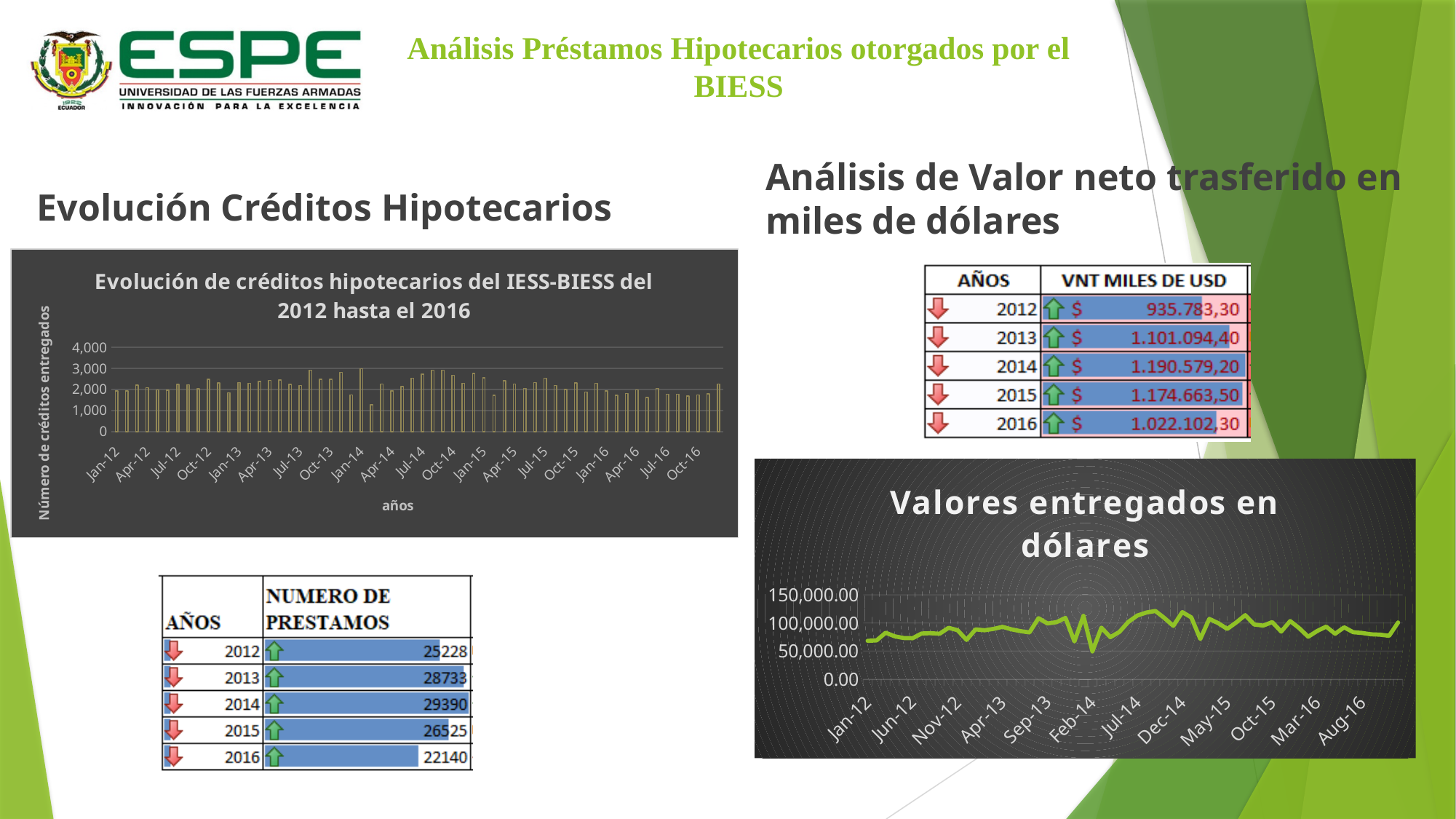
In the 'Valores entregados en dólares' line chart, is the value for Jan-12 greater or less than 100,000.00? less In the 'Evolución de créditos hipotecarios' bar chart, is the value for Oct-13 greater or less than 2,000? greater In the 'Valores entregados en dólares' line chart, near which x-axis label does the line reach its lowest point? Feb-14 In the 'Evolución de créditos hipotecarios' bar chart, is the value for Oct-16 greater or less than 2,000? less In the 'Evolución de créditos hipotecarios' bar chart, do the values generally rise or fall from mid-2014 to the end of 2016? fall How many x-axis tick labels are shown on the 'Valores entregados en dólares' line chart? 12 In the 'Evolución de créditos hipotecarios' bar chart, what is the label on the vertical axis? Número de créditos entregados In the 'Evolución de créditos hipotecarios' bar chart, what is the label on the horizontal axis? años What kind of chart is the 'Evolución de créditos hipotecarios del IESS-BIESS del 2012 hasta el 2016' chart? bar chart What kind of chart is the 'Valores entregados en dólares' chart? line chart